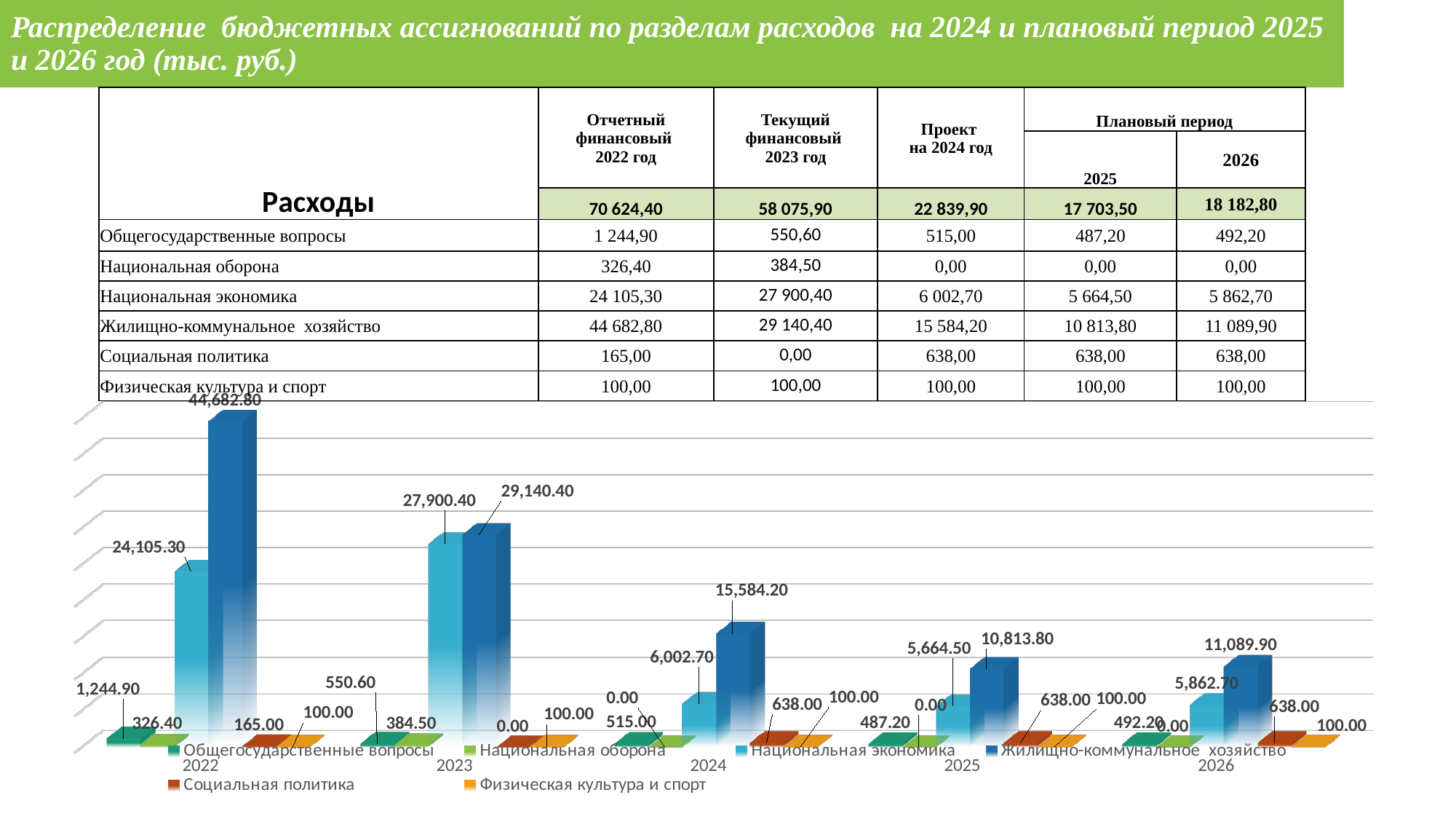
In which year is the Национальная экономика bar the lowest? 2025 How many series does the chart legend list? 6 In which year is the Жилищно-коммунальное хозяйство bar the highest? 2022 How many year categories are shown along the x axis of the chart? 5 What is the value for Жилищно-коммунальное хозяйство in 2022 on the chart? 44,682.80 What kind of chart is shown on the slide? bar chart What is the value for Национальная экономика in 2023 on the chart? 27,900.40 What is the value for Жилищно-коммунальное хозяйство in 2024 on the chart? 15,584.20 What is the difference between the Жилищно-коммунальное хозяйство values for 2026 and 2025 on the chart? 276.10 Does the Жилищно-коммунальное хозяйство value rise or fall from 2022 to 2025 on the chart? fall What is the value for Общегосударственные вопросы in 2025 on the chart? 487.20 Which is larger in 2026: Жилищно-коммунальное хозяйство or Национальная экономика? Жилищно-коммунальное хозяйство